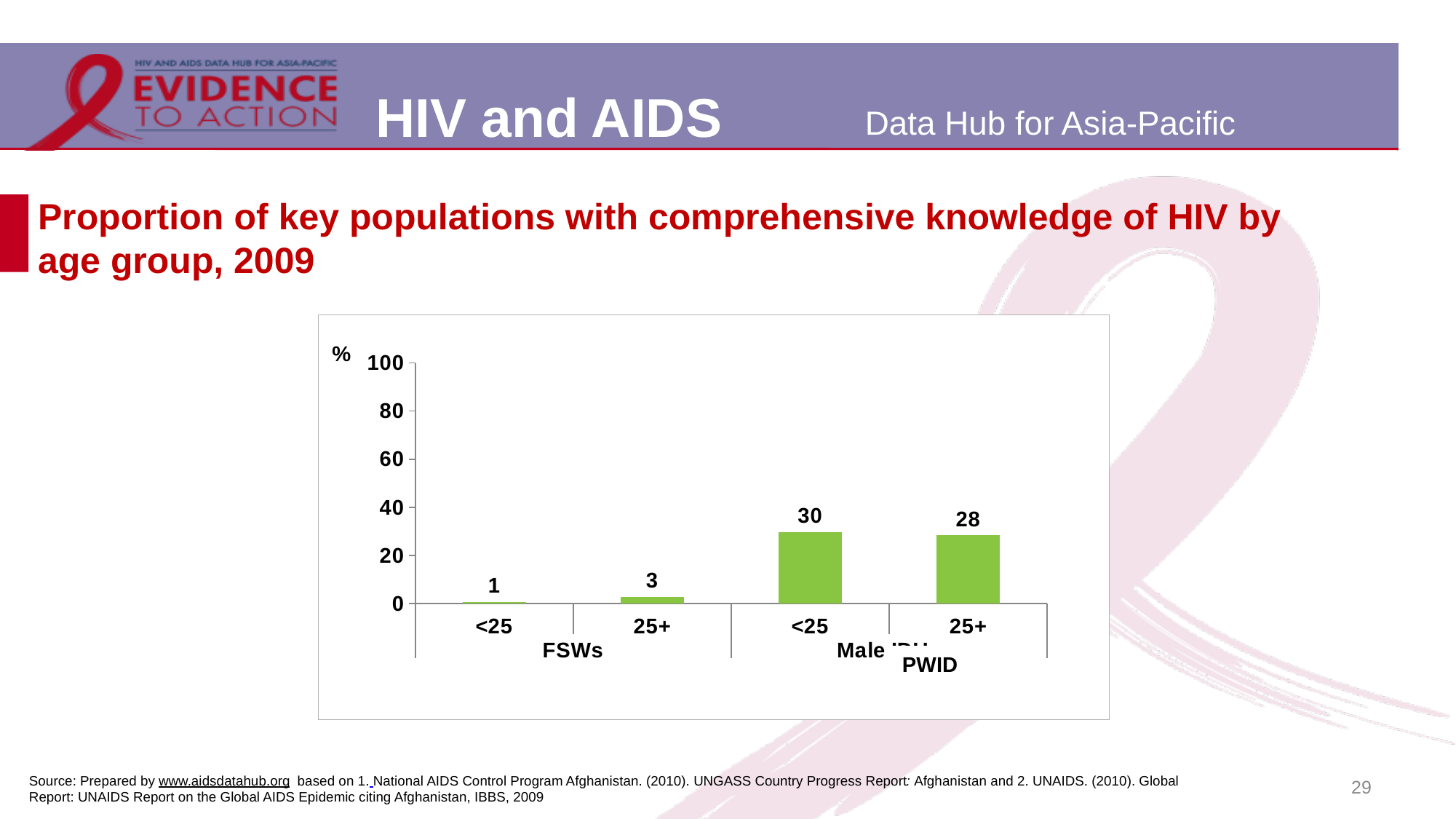
What is the value for Male PWID aged <25? 30 Which bar has the highest value? Male PWID <25 What is the difference between the values for FSWs 25+ and FSWs <25? 2 How many bars are plotted in the chart? 4 What type of chart is shown on the slide? bar chart Which is larger, the value for FSWs 25+ or the value for Male PWID 25+? Male PWID 25+ What is the value for FSWs aged 25+? 3 Which bar has the lowest value? FSWs <25 What is the value for Male PWID aged 25+? 28 What is the value for FSWs aged <25? 1 What is the difference between the values for Male PWID <25 and Male PWID 25+? 2 What is the maximum value shown on the vertical axis? 100